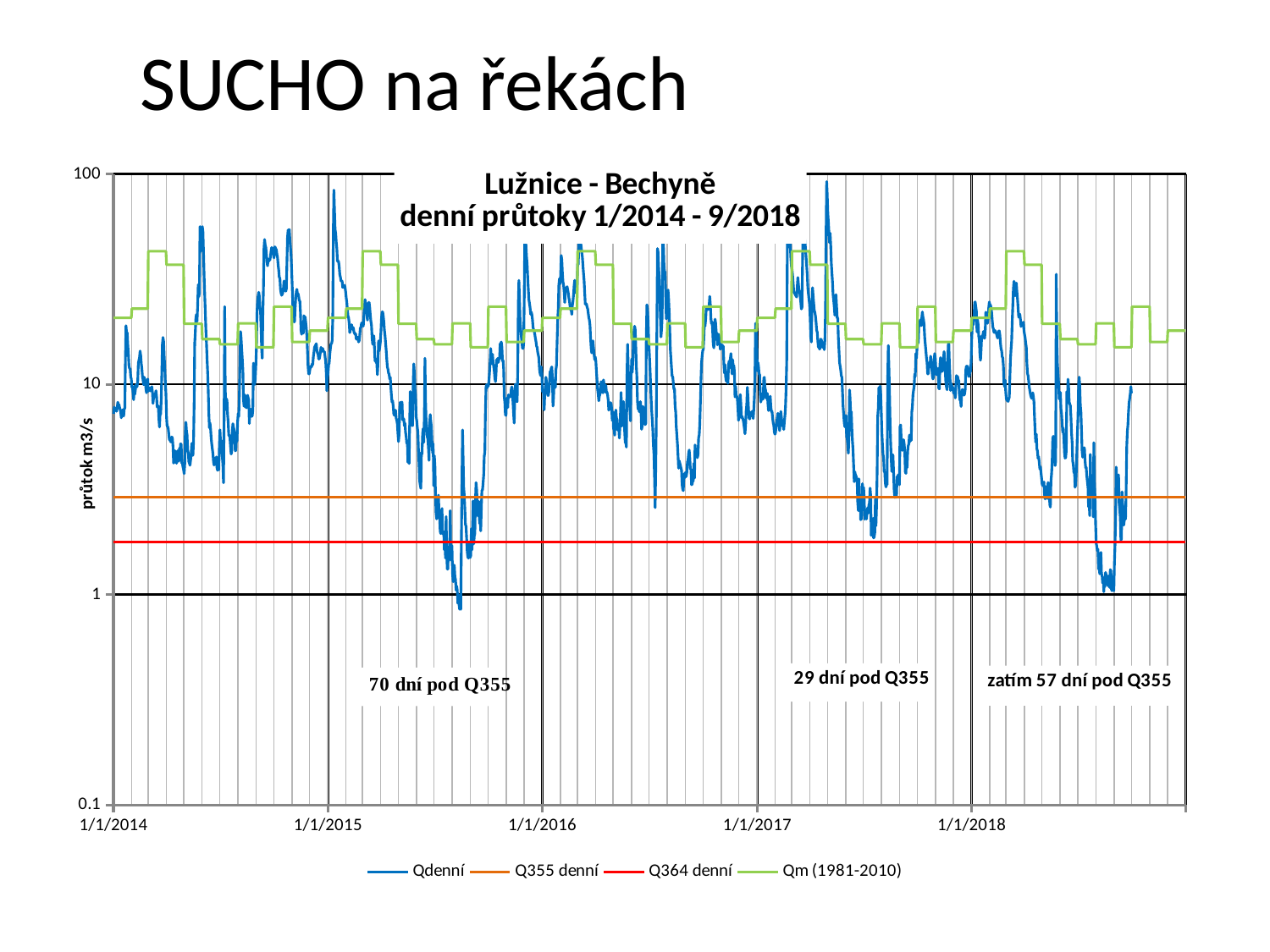
Is the Qm (1981-2010) line greater or less than 10 throughout the chart? greater What kind of chart is shown on the slide? line chart How many series does the chart legend list? 4 What is the label of the vertical axis? průtok m3/s Is the value of the Q364 denní line greater or less than 1? greater How many days below Q355 does the annotation for 2018 report so far? zatím 57 dní Which series is higher, Qm (1981-2010) or Q355 denní? Qm (1981-2010) How many days below Q355 does the annotation for 2015 report? 70 dní What is the title of the chart? Lužnice - Bechyně denní průtoky 1/2014 - 9/2018 Is the value of the Q355 denní line greater or less than 10? less Which series is drawn higher on the chart, Q355 denní or Q364 denní? Q355 denní